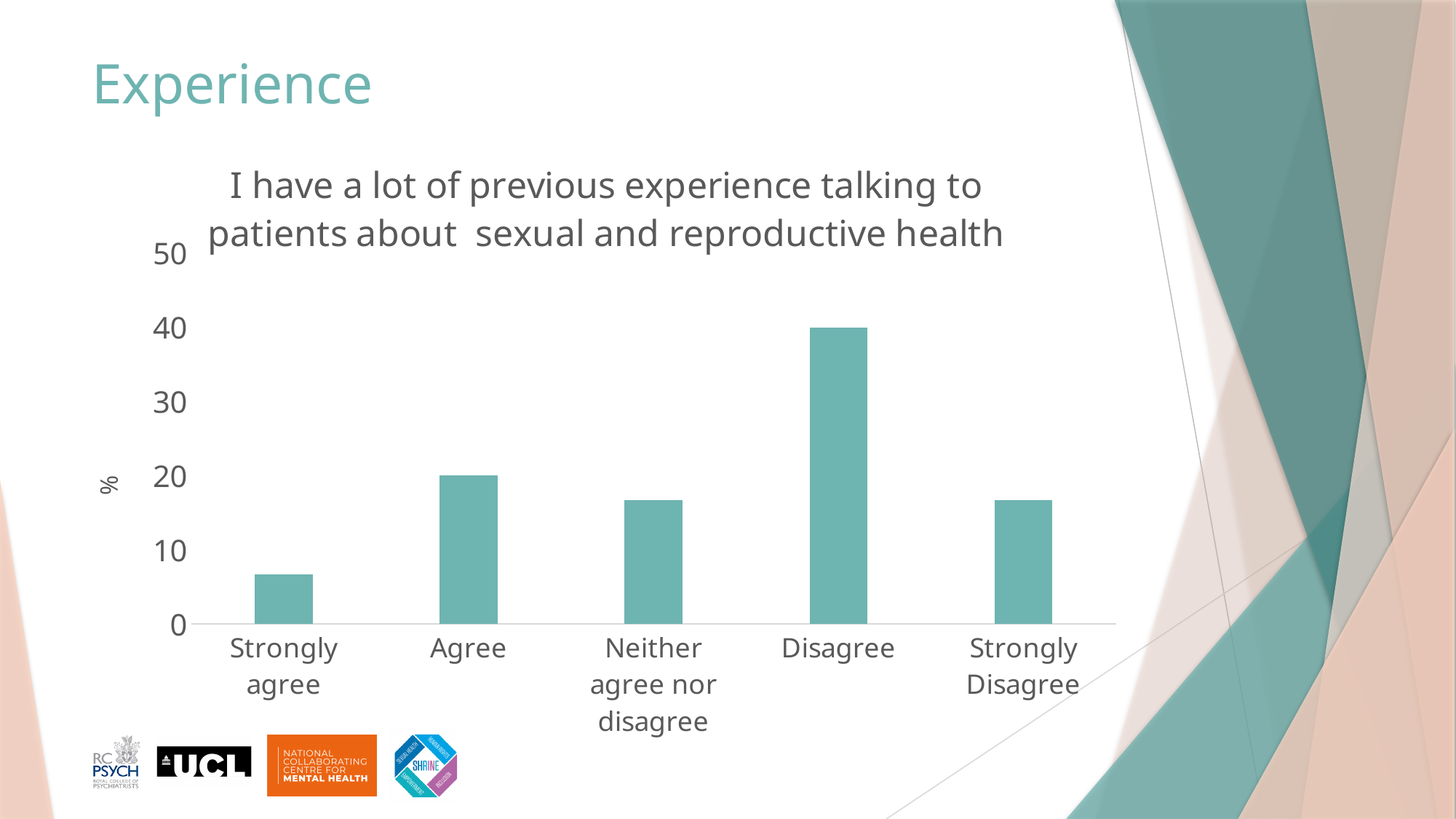
Is the value for Strongly agree greater or less than 10? less What is the value for Disagree? 40 Which category has the highest value? Disagree Is the value for Strongly Disagree greater or less than 20? less What is the value for Agree? 20 How many categories are shown on the x axis of the chart? 5 Which category has the lowest value? Strongly agree Which is larger, the value for Agree or the value for Strongly agree? Agree What type of chart is shown on the slide? bar chart What is the title of the chart? I have a lot of previous experience talking to patients about sexual and reproductive health What label is shown on the y axis of the chart? % Is the value for Neither agree nor disagree greater or less than 10? greater